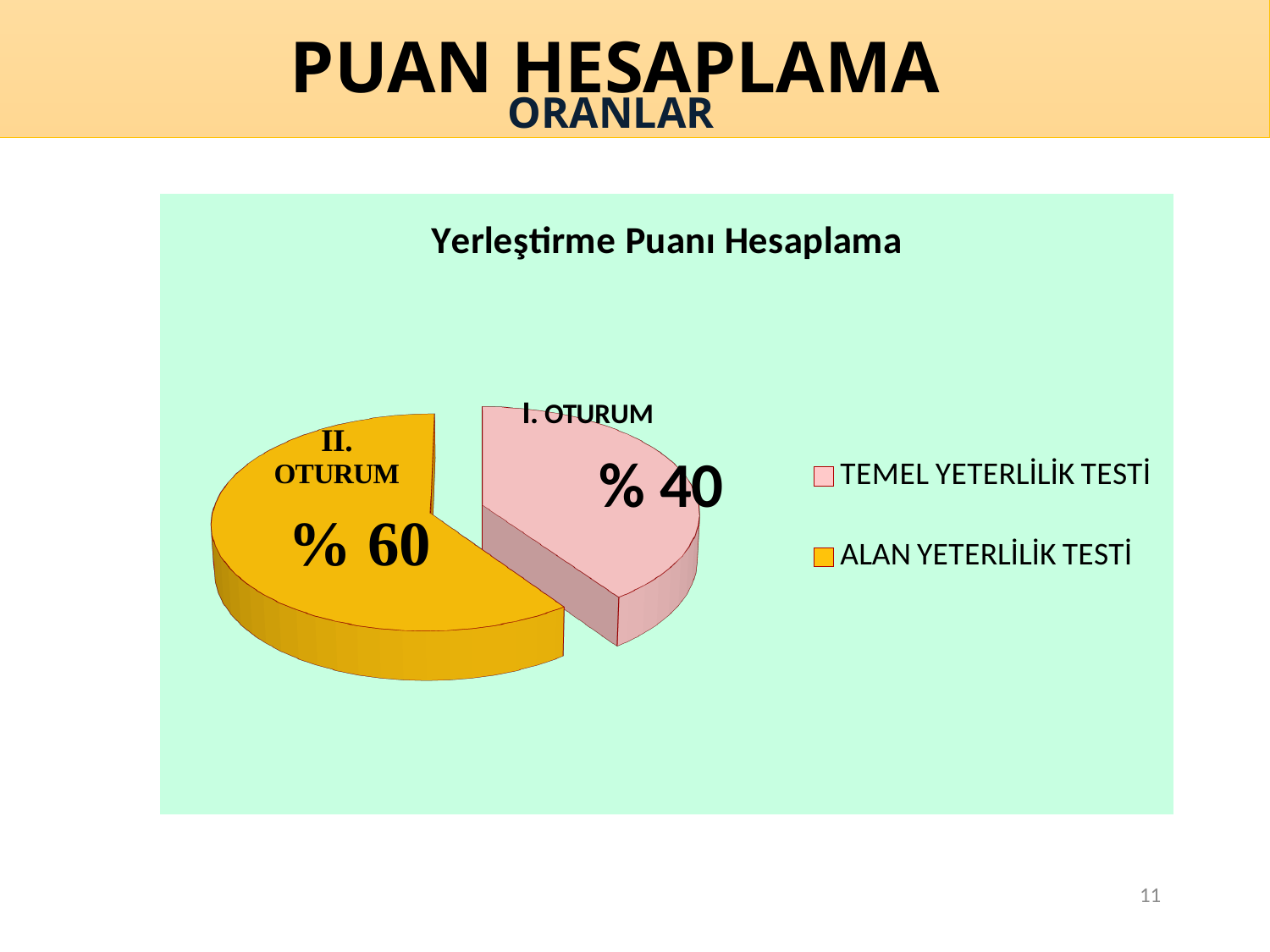
What is the title of the chart? Yerleştirme Puanı Hesaplama How many slices does the pie chart have? 2 Which slice is the largest in the pie chart? ALAN YETERLİLİK TESTİ What share of the pie does TEMEL YETERLİLİK TESTİ have? % 40 Which slice is the smallest in the pie chart? TEMEL YETERLİLİK TESTİ What share of the pie does ALAN YETERLİLİK TESTİ have? % 60 What value is labelled on the I. OTURUM slice? % 40 What kind of chart is shown on the slide? Pie chart Which colour represents ALAN YETERLİLİK TESTİ in the legend? Yellow Which is larger: the share for TEMEL YETERLİLİK TESTİ or for ALAN YETERLİLİK TESTİ? ALAN YETERLİLİK TESTİ What value is labelled on the II. OTURUM slice? % 60 What is the difference between the II. OTURUM share and the I. OTURUM share? 20 percentage points